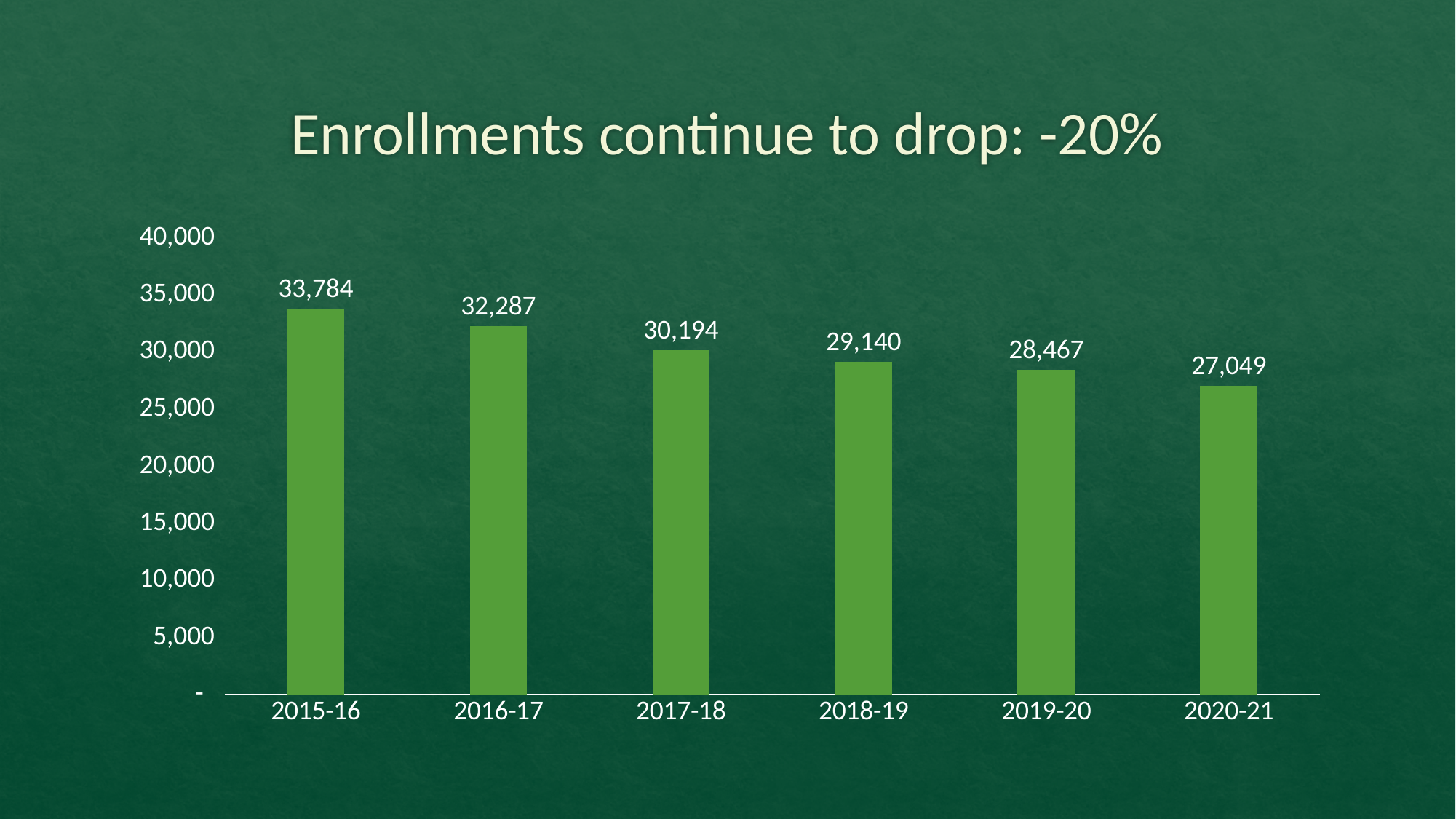
Do the enrollment values rise or fall from 2015-16 to 2020-21? fall What is the enrollment value for 2015-16? 33,784 What is the difference in enrollment between 2015-16 and 2020-21? 6,735 How many years are shown on the chart? 6 What is the enrollment value for 2018-19? 29,140 What is the difference in enrollment between 2016-17 and 2017-18? 2,093 What is the enrollment value for 2020-21? 27,049 Which is larger, the enrollment for 2017-18 or for 2019-20? 2017-18 Which year has the lowest enrollment? 2020-21 Which year has the highest enrollment? 2015-16 Is the value for 2019-20 greater or less than 30,000? less What kind of chart is shown on the slide? bar chart